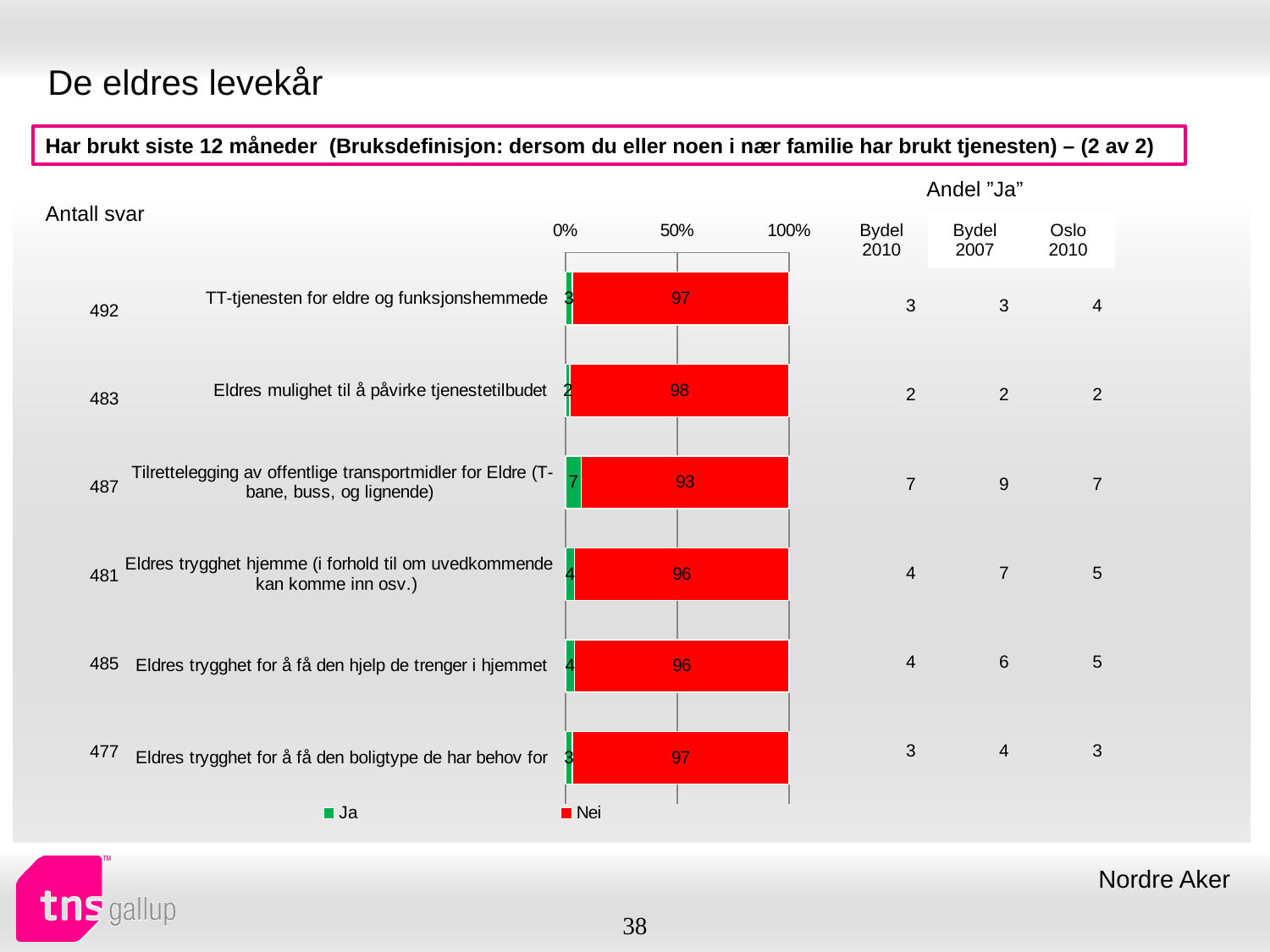
Which category has the highest Ja value? Tilrettelegging av offentlige transportmidler for Eldre (T-bane, buss, og lignende) How many categories are plotted in the chart? 6 What is the Nei value for 'TT-tjenesten for eldre og funksjonshemmede'? 97 What is the difference between the Nei values for 'Eldres mulighet til å påvirke tjenestetilbudet' and 'Tilrettelegging av offentlige transportmidler for Eldre (T-bane, buss, og lignende)'? 5 What are the two series named in the chart legend? Ja and Nei Which category has the lowest Nei value? Tilrettelegging av offentlige transportmidler for Eldre (T-bane, buss, og lignende) What is the Nei value for 'Eldres trygghet for å få den hjelp de trenger i hjemmet'? 96 How many series does the chart legend list? 2 What is the Ja value for 'Tilrettelegging av offentlige transportmidler for Eldre (T-bane, buss, og lignende)'? 7 What is the Nei value for 'Eldres mulighet til å påvirke tjenestetilbudet'? 98 Which is larger, the Ja value for 'Eldres trygghet hjemme (i forhold til om uvedkommende kan komme inn osv.)' or the Ja value for 'Eldres trygghet for å få den boligtype de har behov for'? Eldres trygghet hjemme (i forhold til om uvedkommende kan komme inn osv.) What kind of chart is shown on the slide? bar chart